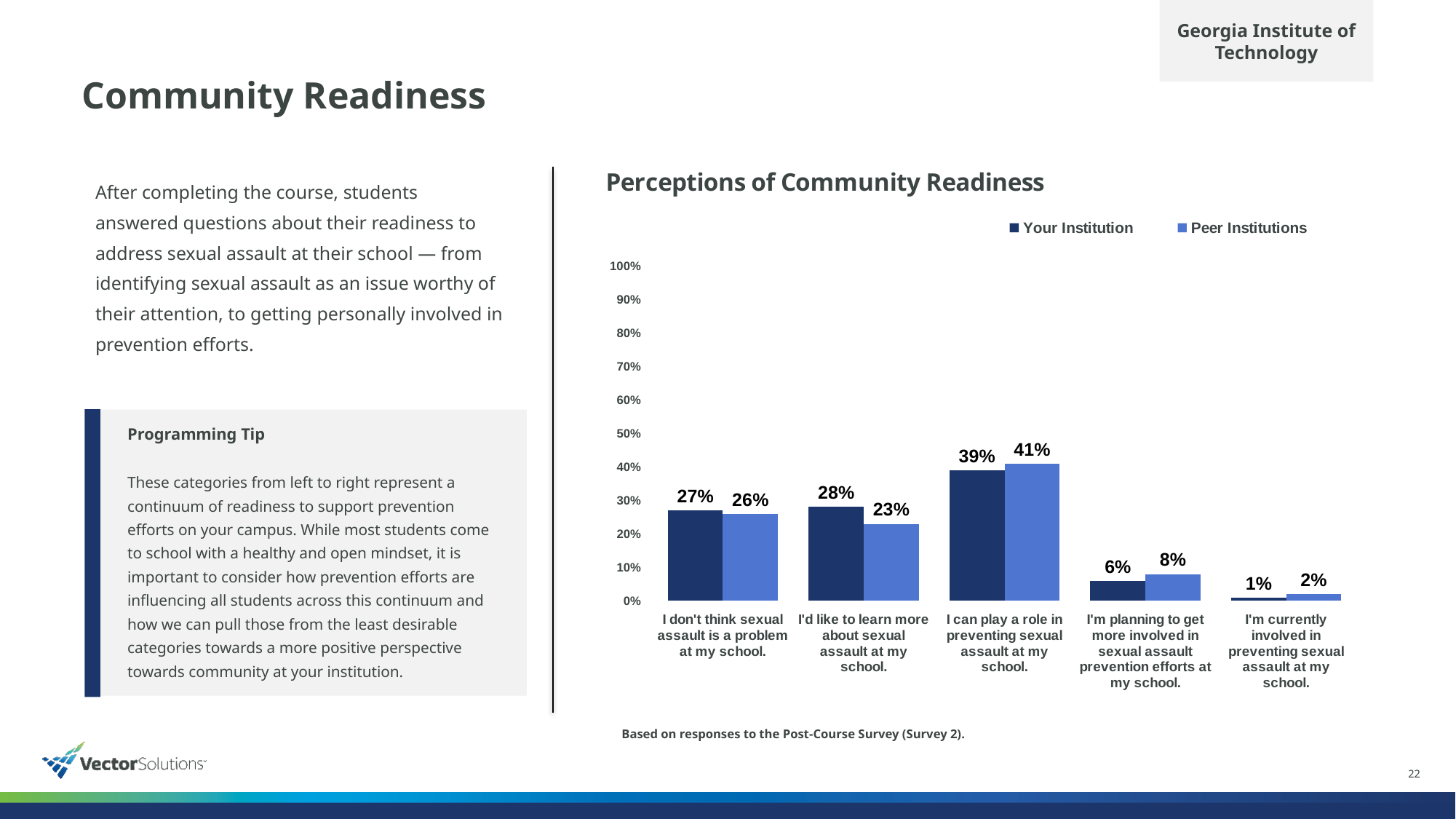
Which category has the lowest Peer Institutions value? I'm currently involved in preventing sexual assault at my school. Is the Your Institution value for "I don't think sexual assault is a problem at my school." greater or less than 20%? greater How many categories are shown on the x axis? 5 What kind of chart is shown on the slide? Bar chart What is the difference between the Peer Institutions and Your Institution values for "I can play a role in preventing sexual assault at my school."? 2% Which category has the highest Your Institution value? I can play a role in preventing sexual assault at my school. How many series does the legend list? 2 What is the Peer Institutions value for "I'd like to learn more about sexual assault at my school."? 23% What is the Peer Institutions value for "I'm planning to get more involved in sexual assault prevention efforts at my school."? 8% For "I'd like to learn more about sexual assault at my school.", which series has the larger value? Your Institution What is the title of the chart? Perceptions of Community Readiness What is the Your Institution value for "I can play a role in preventing sexual assault at my school."? 39%